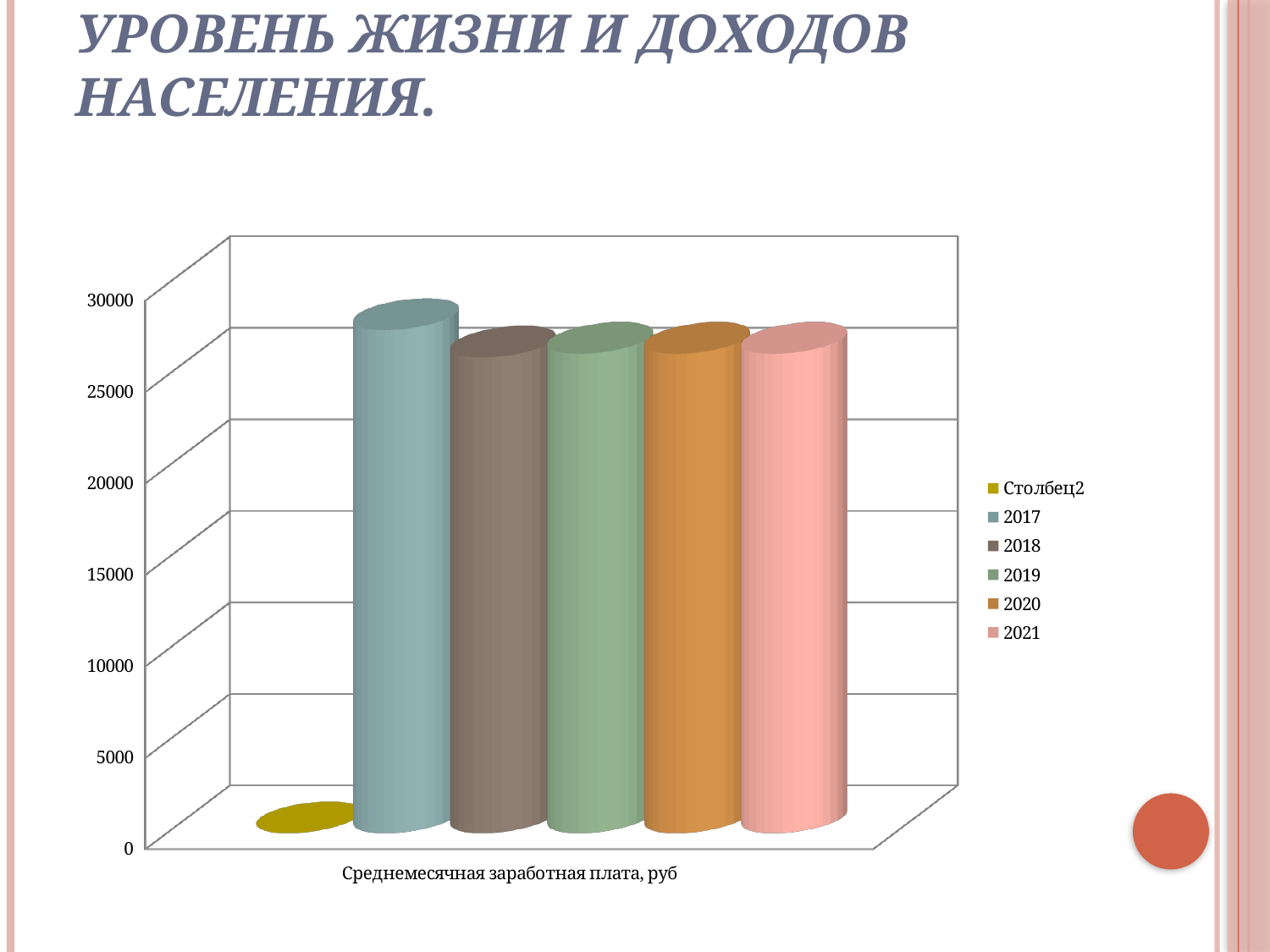
Is the value for 2017 greater or less than 25000? greater Which series has the highest bar? 2017 How many series does the legend list? 6 How many categories are shown on the x axis? 1 What kind of chart is shown on the slide? bar chart Is the value for Столбец2 greater or less than 5000? less Which series has the lowest bar? Столбец2 Is the value for 2019 greater or less than 30000? less What is the title of the slide? Уровень жизни и доходов населения. What is the category label on the x axis? Среднемесячная заработная плата, руб Which is larger, the value for 2017 or the value for 2018? 2017